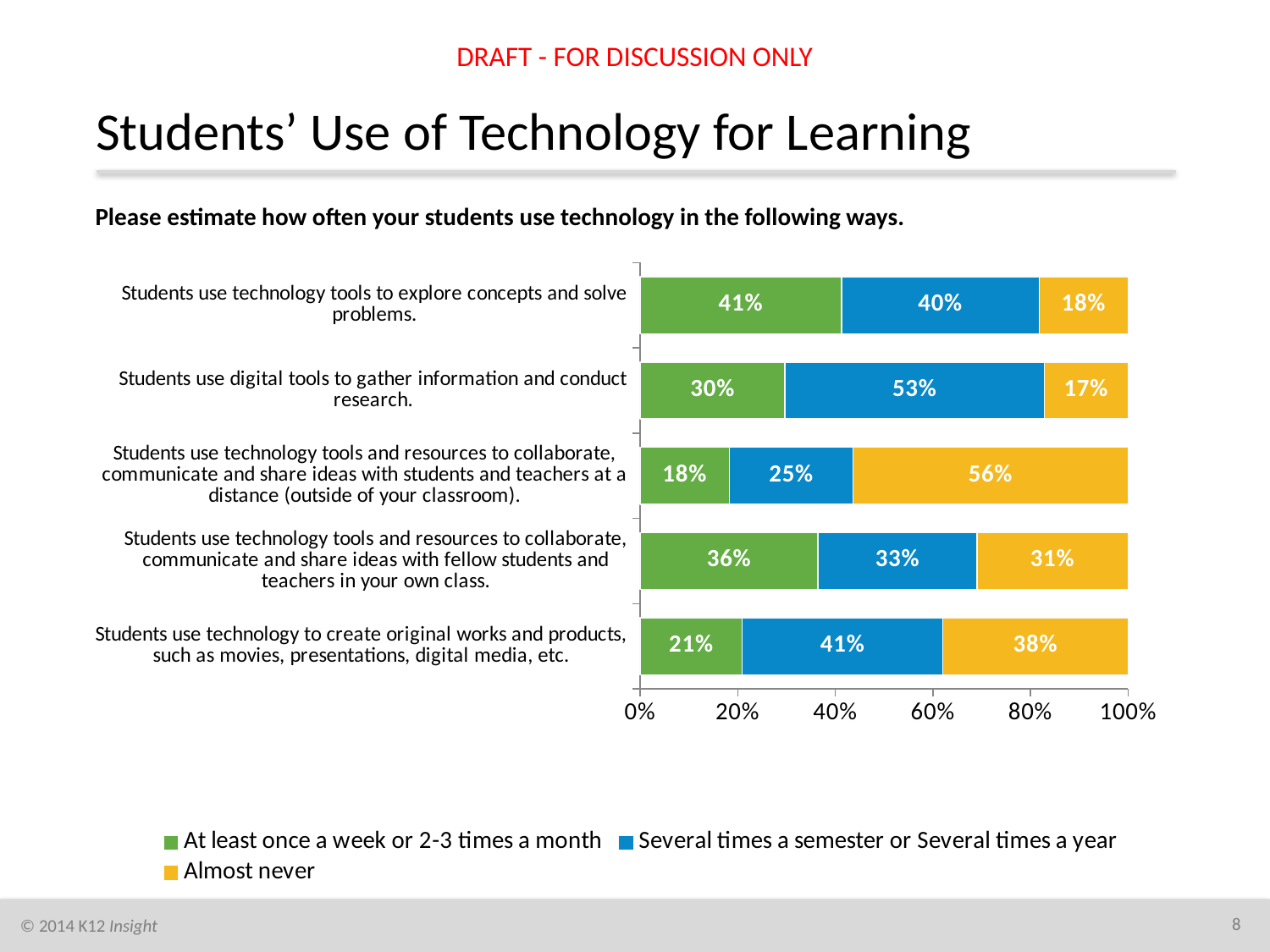
What is the 'Almost never' value for students using digital tools to gather information and conduct research? 17% What kind of chart is shown on the slide? Stacked horizontal bar chart Which category has the highest 'Almost never' percentage? Students use technology tools and resources to collaborate, communicate and share ideas with students and teachers at a distance (outside of your classroom). Which colour represents 'Almost never' in the chart? Yellow What is the total of the stacked bar for students using technology tools to explore concepts and solve problems? 99% How many categories (survey items) are shown on the chart? 5 How many series does the legend list? 3 What percentage of respondents said students use technology tools to explore concepts and solve problems at least once a week or 2-3 times a month? 41% Which is larger: the 'At least once a week or 2-3 times a month' value for gathering information and conducting research, or for creating original works and products? Gathering information and conducting research (30%) What is the difference between the 'Almost never' values for collaborating at a distance (56%) and collaborating in your own class (31%)? 25 percentage points What is the 'Several times a semester or Several times a year' value for students using technology to create original works and products? 41% Which category has the lowest 'At least once a week or 2-3 times a month' percentage? Students use technology tools and resources to collaborate, communicate and share ideas with students and teachers at a distance (outside of your classroom).